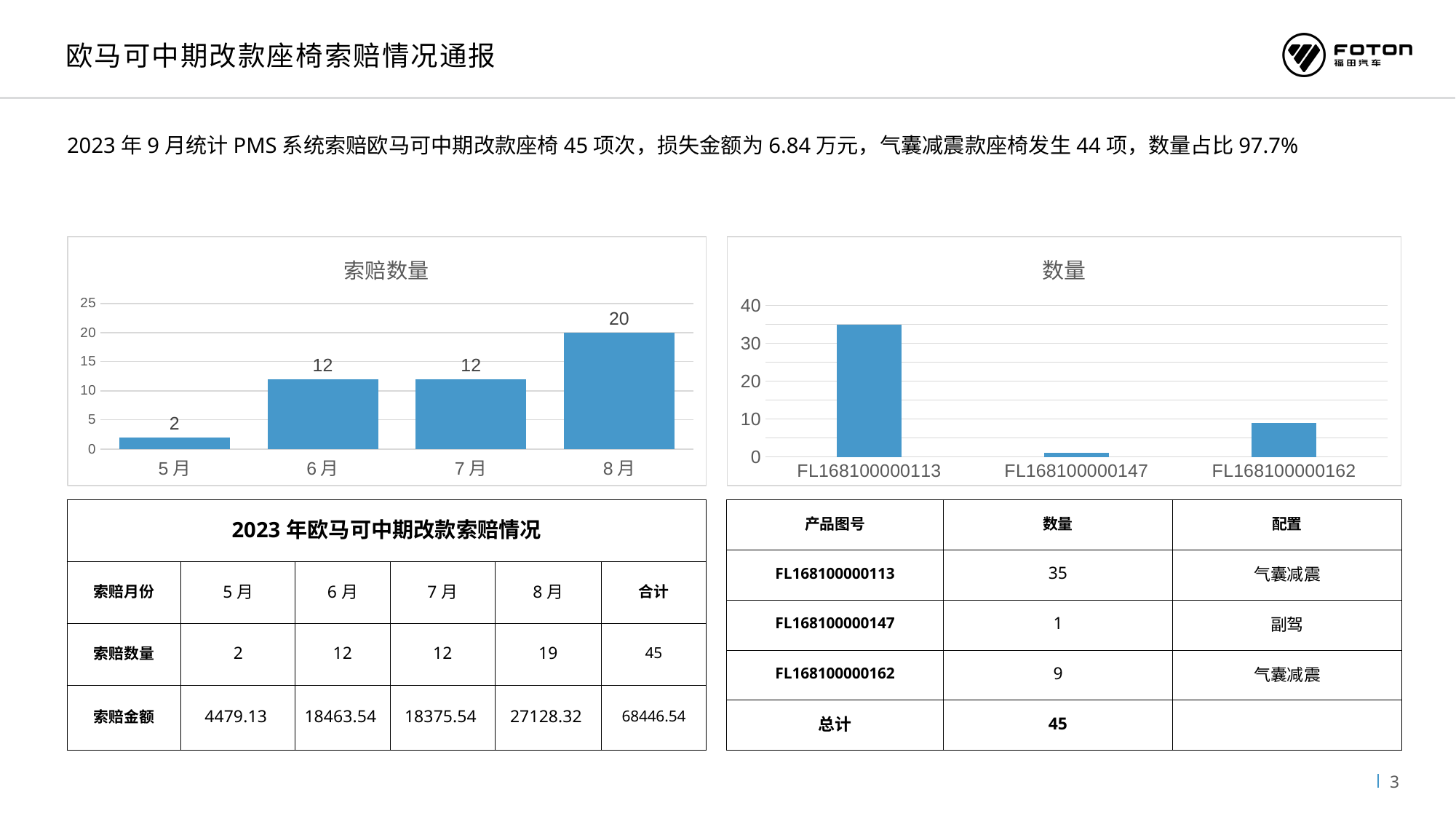
In the chart titled 索赔数量, do the values generally rise or fall from 5月 to 8月? rise In the chart titled 数量, which product number has the lowest value? FL168100000147 In the chart titled 索赔数量, which month has the lowest value? 5月 In the chart titled 索赔数量, what is the difference between the values for 8月 and 6月? 8 What kind of chart is the chart titled 索赔数量? bar chart In the chart titled 索赔数量, what is the value for 5月? 2 In the chart titled 数量, is the value for FL168100000162 greater or less than 10? less In the chart titled 索赔数量, which month has the highest value? 8月 In the chart titled 索赔数量, what is the value for 8月? 20 In the chart titled 数量, which product number has the highest value? FL168100000113 In the chart titled 数量, is the value for FL168100000113 greater or less than 30? greater In the chart titled 索赔数量, how many months are shown on the x axis? 4